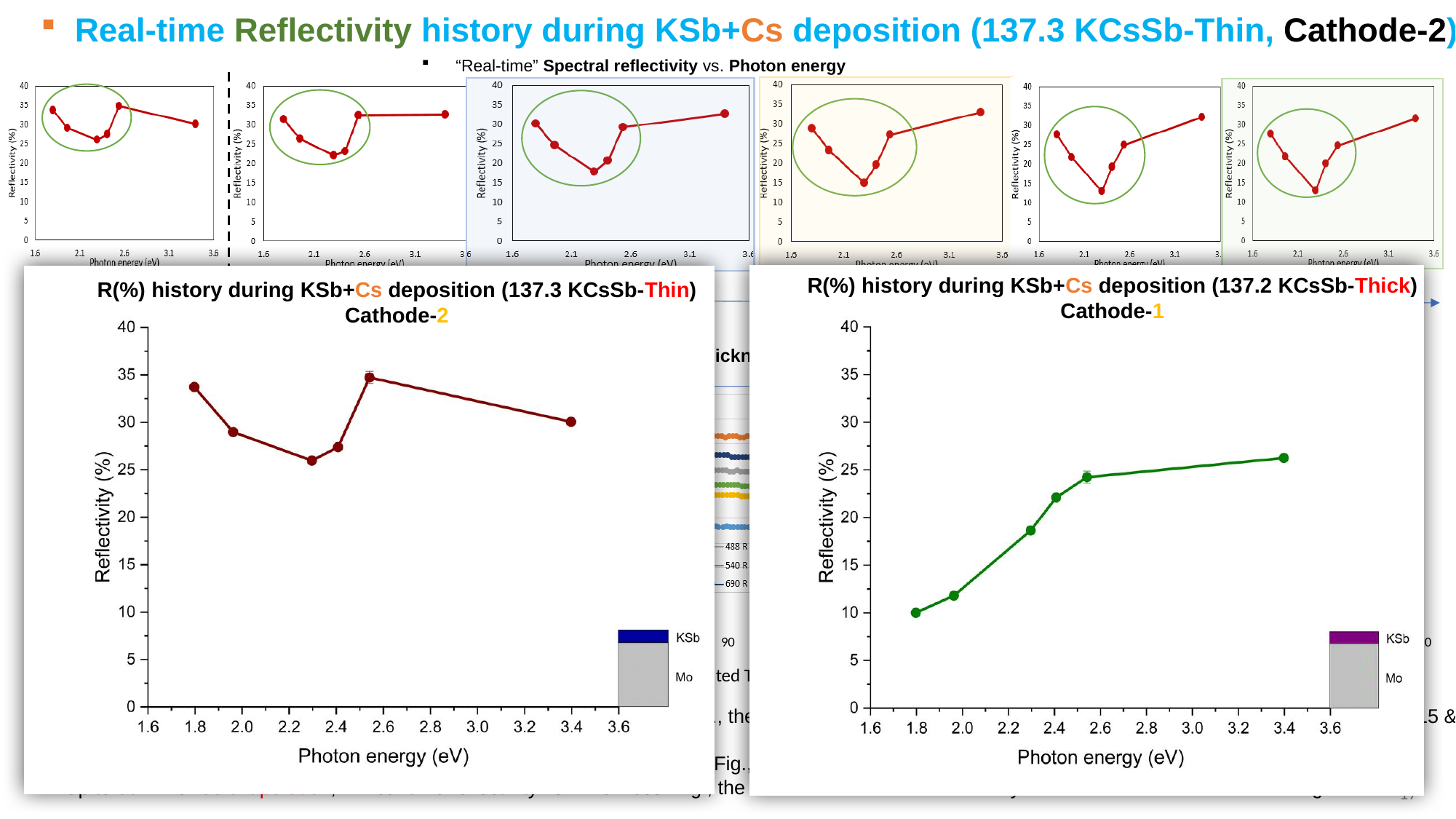
What is the x-axis label of the Cathode-1 (137.2 KCsSb-Thick) chart? Photon energy (eV) In the Cathode-1 (137.2 KCsSb-Thick) chart, at which photon energy is the reflectivity lowest? 1.8 eV In the Cathode-1 (137.2 KCsSb-Thick) chart, do the reflectivity values rise or fall as photon energy increases? rise In the Cathode-1 (137.2 KCsSb-Thick) chart, is the reflectivity at 1.8 eV greater or less than 15? less In the Cathode-2 (137.3 KCsSb-Thin) chart, is the reflectivity at about 2.3 eV greater or less than 30? less What is the y-axis label of the Cathode-2 (137.3 KCsSb-Thin) chart? Reflectivity (%) How many data points are plotted in the 'R(%) history during KSb+Cs deposition (137.2 KCsSb-Thick) Cathode-1' chart? 6 In the Cathode-2 (137.3 KCsSb-Thin) chart, is the reflectivity at 1.8 eV greater or less than 30? greater In the Cathode-1 (137.2 KCsSb-Thick) chart, at which photon energy is the reflectivity highest? 3.4 eV What kind of chart is the 'R(%) history during KSb+Cs deposition (137.3 KCsSb-Thin) Cathode-2' chart? line chart In the Cathode-2 (137.3 KCsSb-Thin) chart, which has the higher reflectivity: the point at 1.8 eV or the point at about 2.0 eV? 1.8 eV In the Cathode-1 (137.2 KCsSb-Thick) chart, which has the higher reflectivity: the point at about 2.3 eV or the point at about 2.4 eV? 2.4 eV